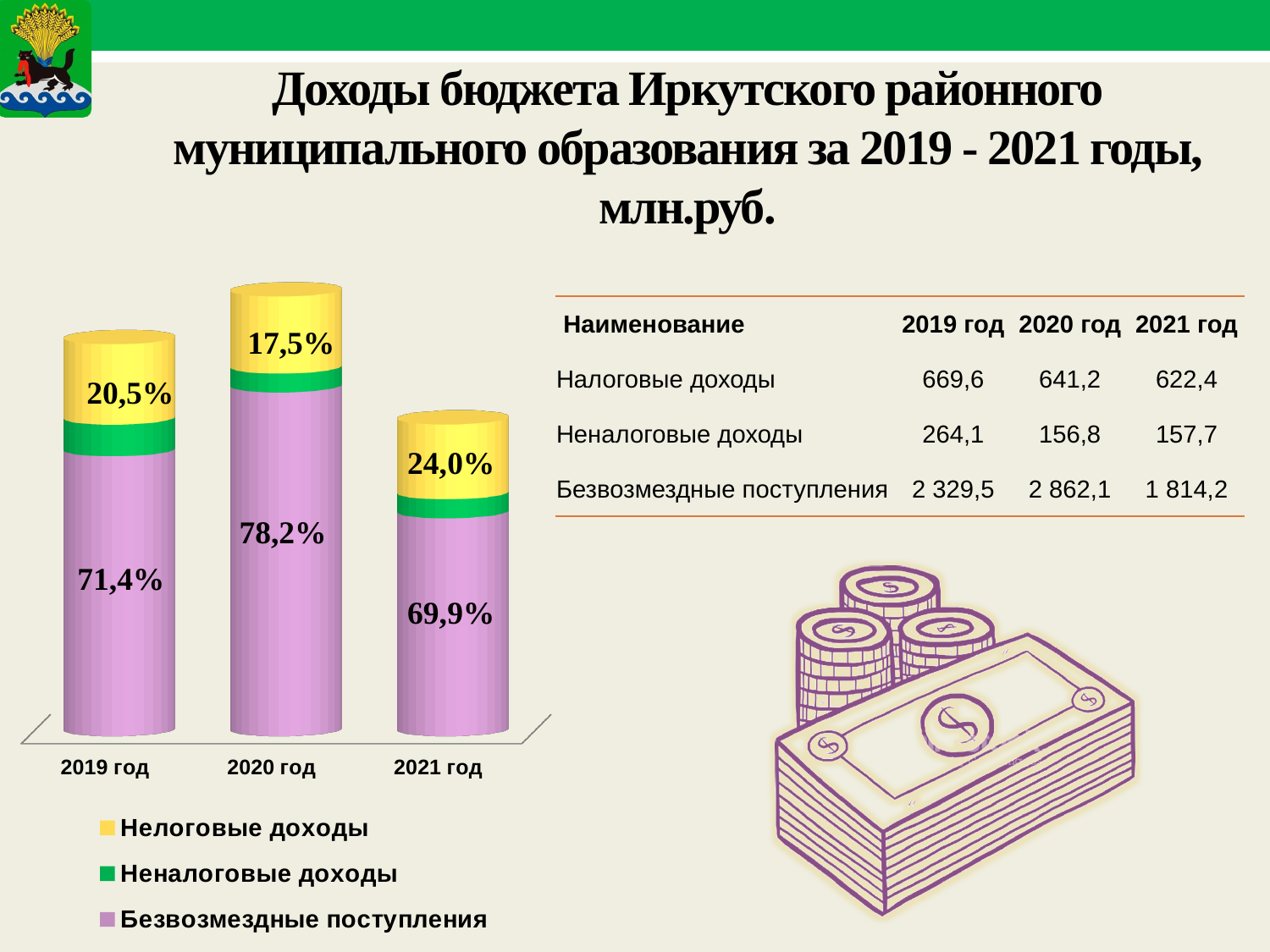
What type of chart is shown on the slide? Stacked bar chart In which year is the share of Безвозмездные поступления the highest? 2020 год What share does Безвозмездные поступления have in the 2019 год bar? 71,4% What is the labelled value for Нелоговые доходы in 2020 год? 17,5% Which year has the larger share of Нелоговые доходы, 2019 год or 2021 год? 2021 год Does the share of Нелоговые доходы rise or fall from 2020 год to 2021 год? Rises What share does Нелоговые доходы have in the 2021 год bar? 24,0% How many years (bars) are shown in the chart? 3 How many series does the chart legend list? 3 In which year is the share of Нелоговые доходы the lowest? 2020 год What is the labelled value for Безвозмездные поступления in 2020 год? 78,2% By how many percentage points does the share of Безвозмездные поступления in 2020 год exceed that in 2021 год? 8,3%